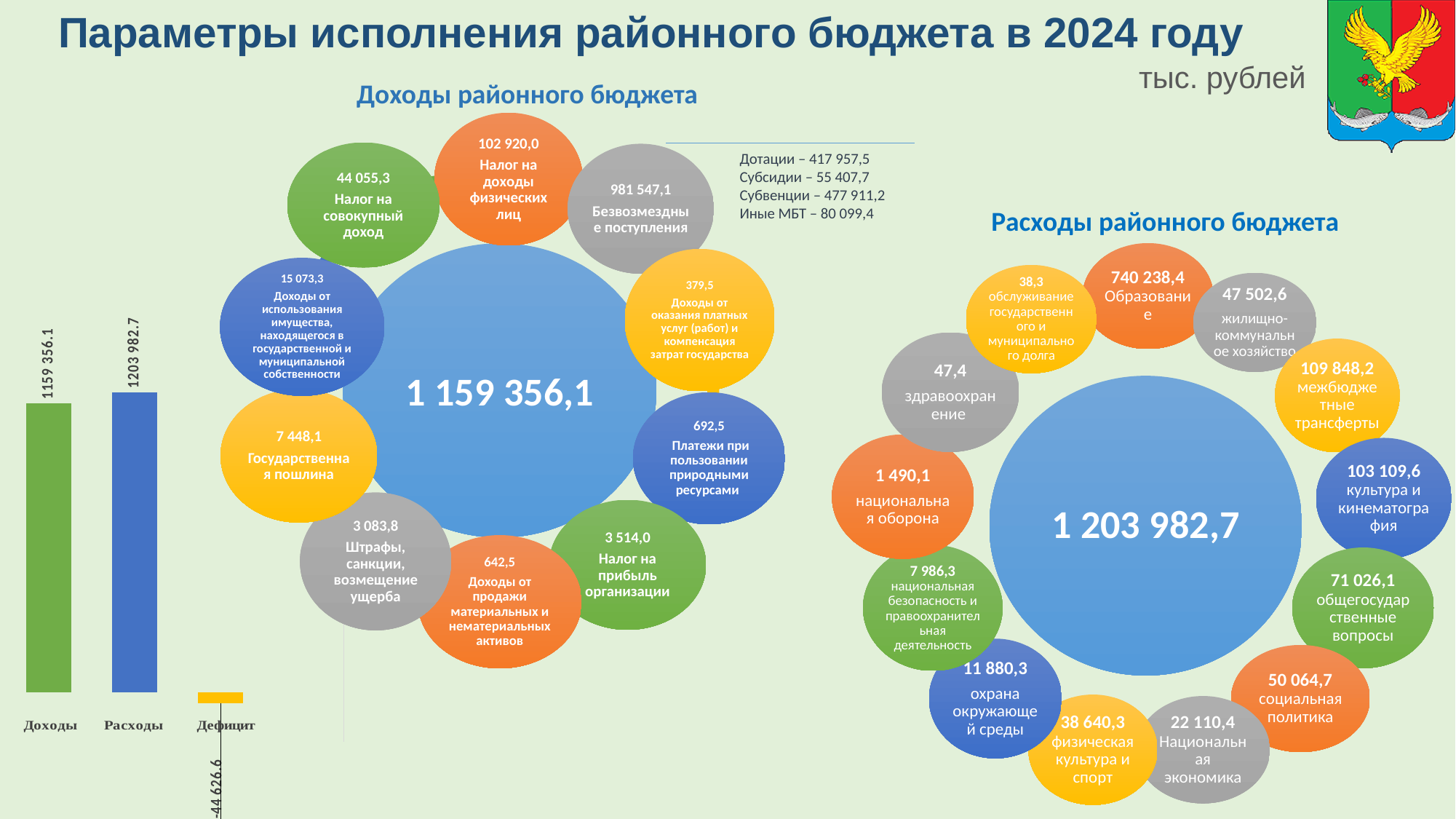
In the bar chart at the left of the slide, what colour is the Доходы bar? green In the bar chart at the left of the slide, which category has the highest value? Расходы In the bar chart at the left of the slide, what is the value for Доходы? 1159 356.1 In the bar chart at the left of the slide, which is larger, Доходы or Расходы? Расходы How many categories does the bar chart at the left of the slide show? 3 In the bar chart at the left of the slide, which category has the lowest value? Дефицит What kind of chart is shown at the left of the slide? bar chart In the bar chart at the left of the slide, what is the value for Расходы? 1203 982.7 In the bubble diagram titled 'Доходы районного бюджета', what is the value for Безвозмездные поступления? 981 547,1 In the bubble diagram titled 'Расходы районного бюджета', what is the value for Образование? 740 238,4 In the bar chart at the left of the slide, what is the value for Дефицит? -44 626.6 In the bar chart at the left of the slide, what is the difference between Расходы and Доходы? 44 626.6